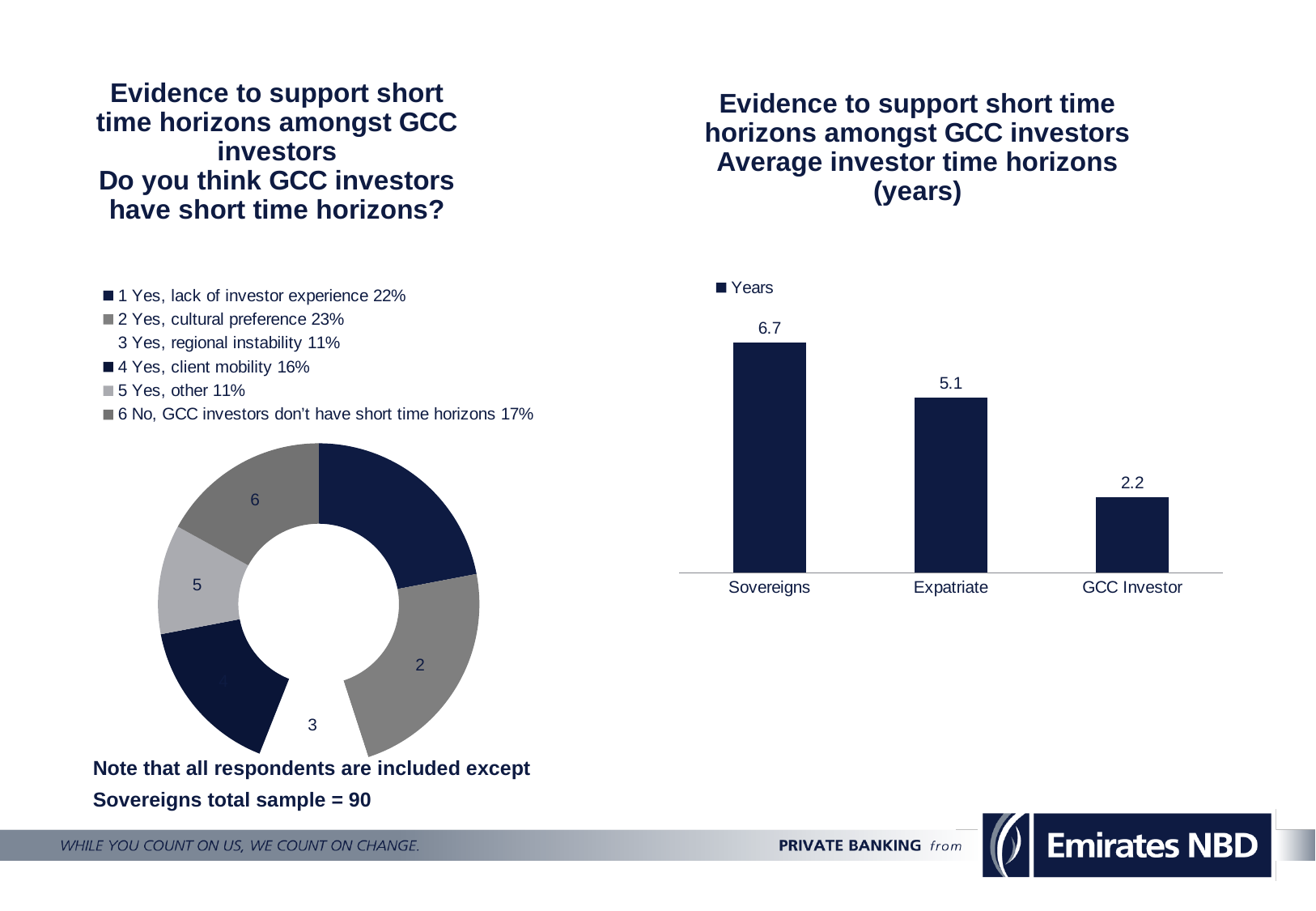
In the doughnut chart on the left, what percentage corresponds to '2 Yes, cultural preference'? 23% In the bar chart on the right, which category has the highest average time horizon? Sovereigns In the bar chart on the right, how many categories are shown on the x axis? 3 In the bar chart on the right, what is the difference between the values for Sovereigns and GCC Investor? 4.5 In the bar chart on the right, which category has the lowest average time horizon? GCC Investor In the bar chart on the right, what is the average investor time horizon for Sovereigns? 6.7 What kind of chart is the chart on the left of the slide? doughnut chart In the doughnut chart on the left, which is larger: '1 Yes, lack of investor experience' or '3 Yes, regional instability'? 1 Yes, lack of investor experience In the doughnut chart on the left, how many entries does the legend list? 6 In the bar chart on the right, what is the value for GCC Investor? 2.2 In the bar chart on the right, do the values rise or fall from left to right? fall In the bar chart on the right, what is the value for Expatriate? 5.1